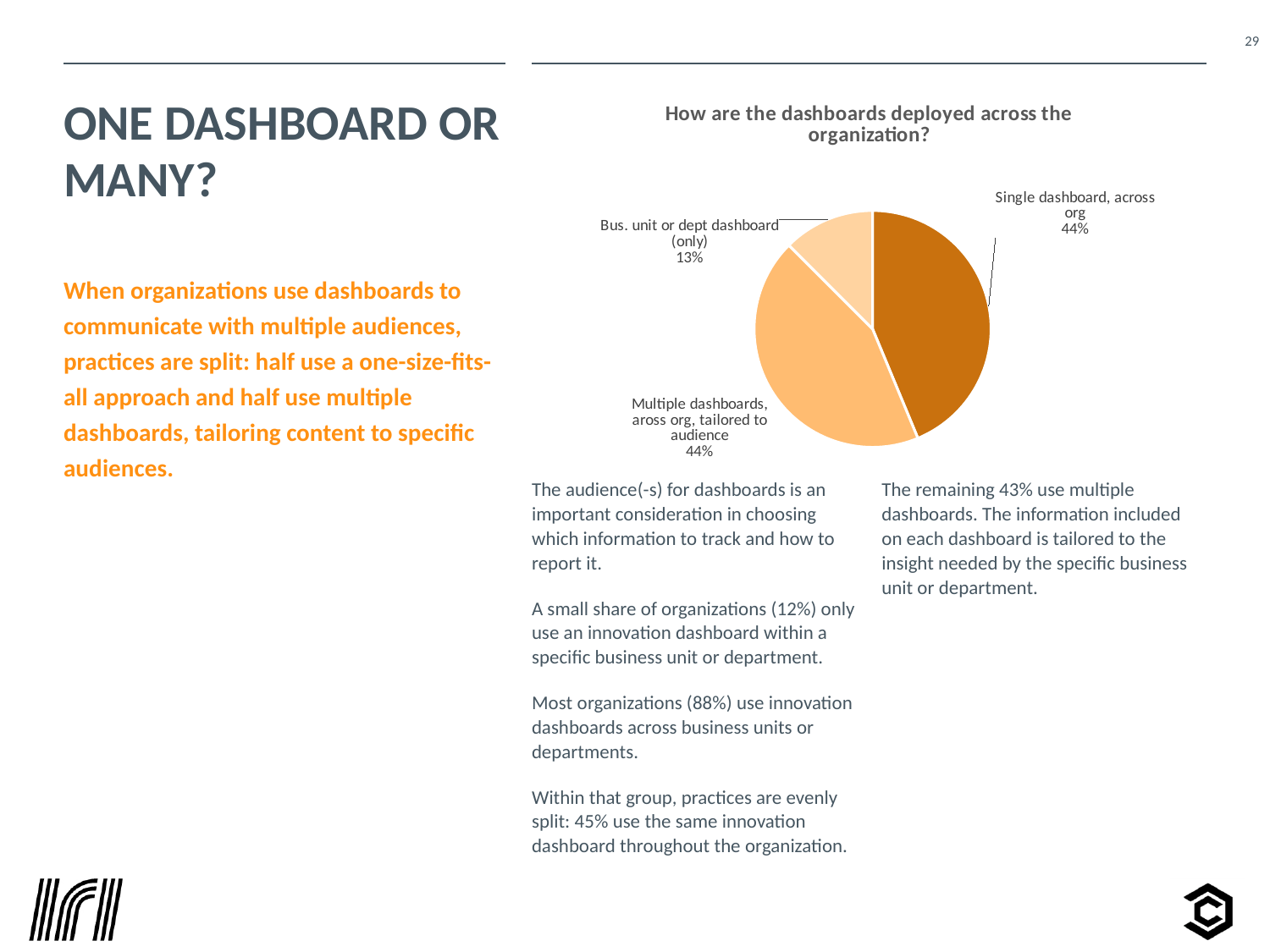
What kind of chart is shown on the slide? pie chart Which category has the smallest slice of the pie? Bus. unit or dept dashboard (only) What share of the pie is "Bus. unit or dept dashboard (only)"? 13% What is the difference in percentage points between the "Multiple dashboards, across org, tailored to audience" slice and the "Bus. unit or dept dashboard (only)" slice? 31 percentage points How many slices does the pie chart have? 3 What is the difference in percentage points between the "Single dashboard, across org" slice and the "Bus. unit or dept dashboard (only)" slice? 31 percentage points Do the "Single dashboard, across org" and "Multiple dashboards, across org, tailored to audience" slices have the same percentage? Yes, both 44% Which is larger: the slice for "Single dashboard, across org" or the slice for "Bus. unit or dept dashboard (only)"? Single dashboard, across org What share of the pie is "Multiple dashboards, across org, tailored to audience"? 44% What is the title of the chart? How are the dashboards deployed across the organization? Which slice of the pie is the lightest in colour? Bus. unit or dept dashboard (only) What share of the pie is "Single dashboard, across org"? 44%